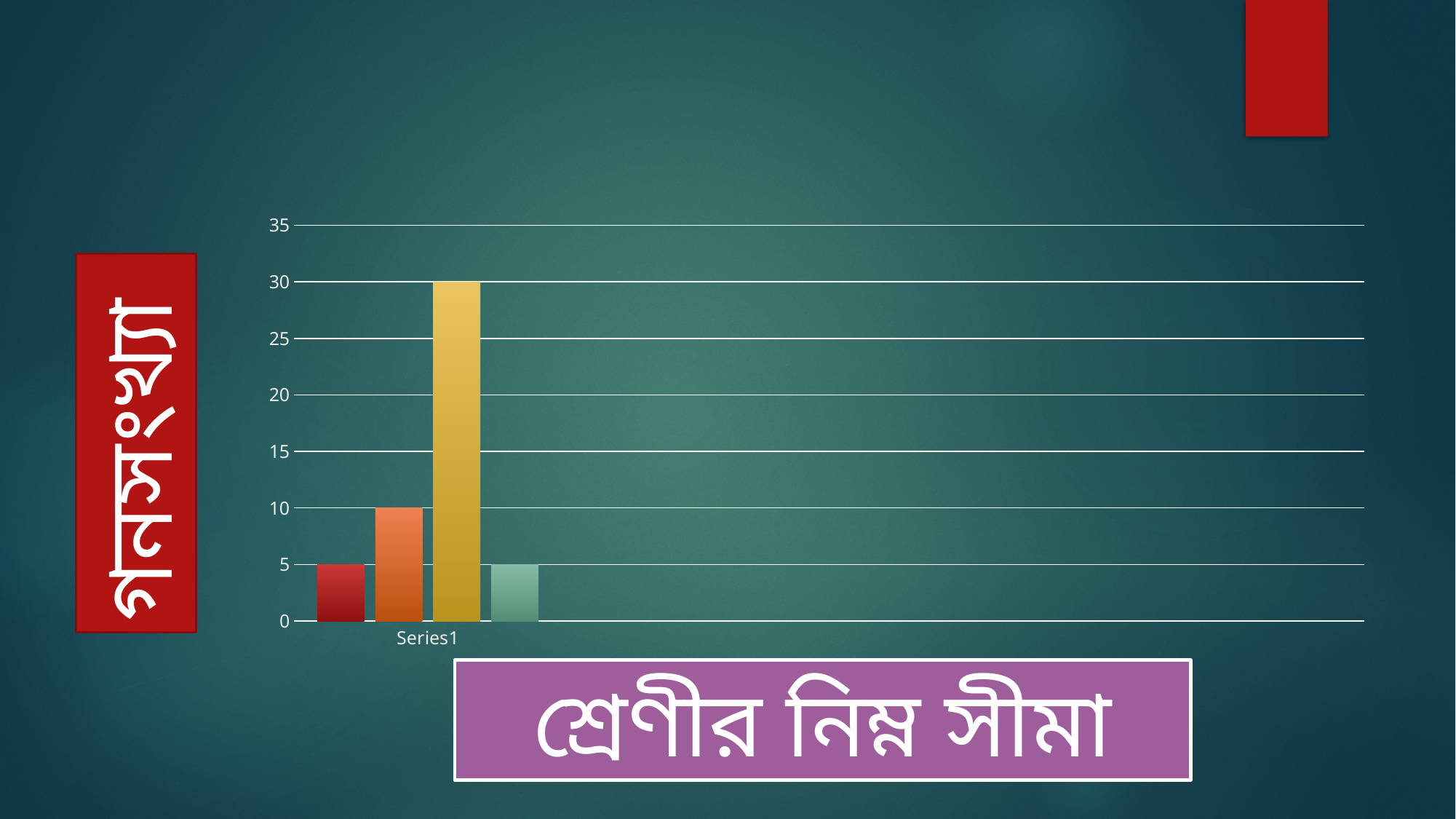
What label appears under the bars on the horizontal axis? Series1 What value does the red bar reach on the vertical axis? 5 Which bar is the tallest in the chart? the yellow bar How many bars are plotted in the chart? 4 What value does the green bar reach on the vertical axis? 5 What kind of chart is shown on the slide? bar chart Which is larger, the orange bar or the green bar? the orange bar What is the highest value shown on the vertical axis? 35 What value does the orange bar reach on the vertical axis? 10 Is the value of the yellow bar greater or less than 25? greater What is the difference between the yellow bar and the orange bar? 20 What value does the yellow bar reach on the vertical axis? 30